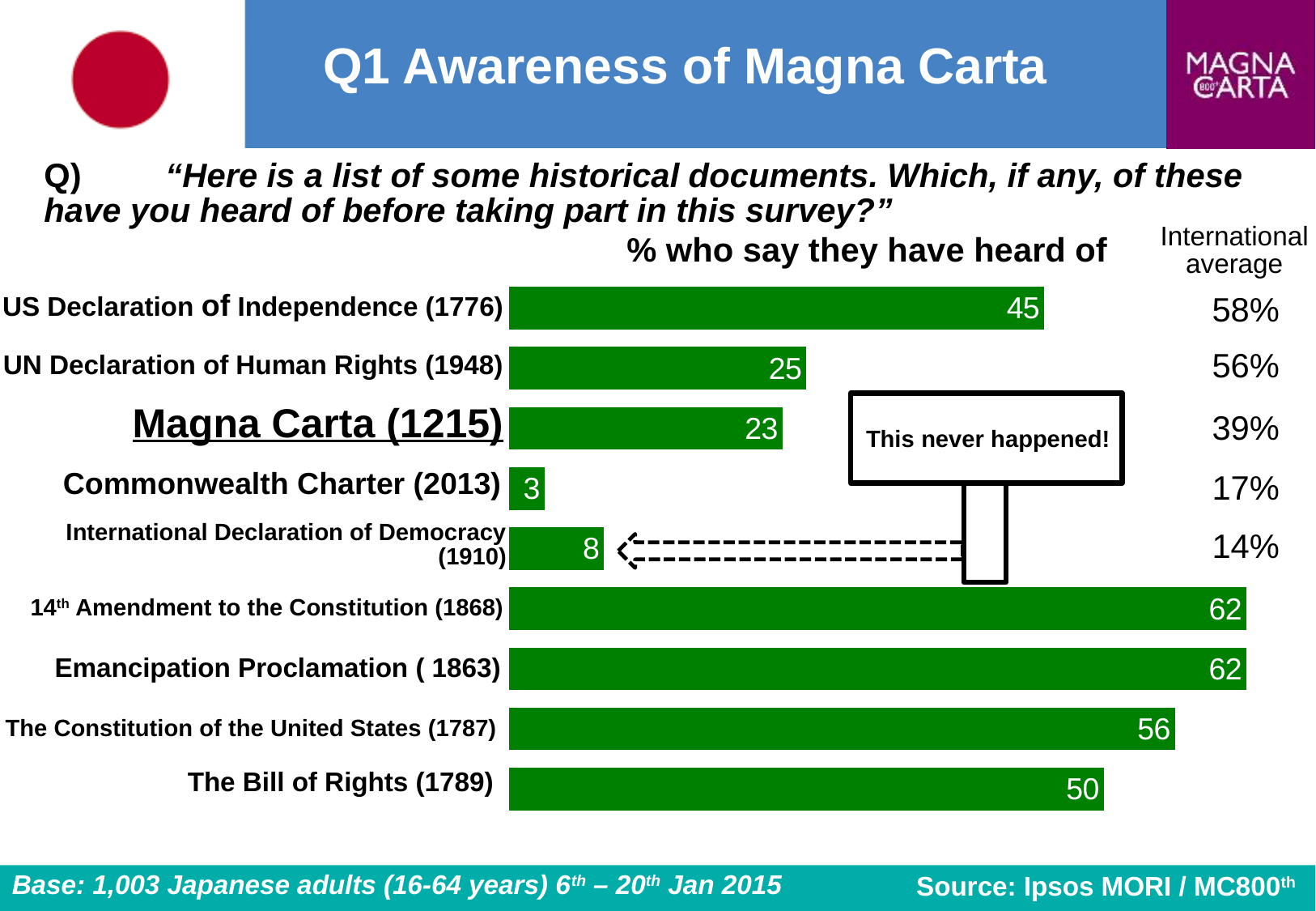
What is the difference between the values for the US Declaration of Independence (1776) and the UN Declaration of Human Rights (1948)? 20 What percentage of respondents say they have heard of the US Declaration of Independence (1776)? 45 What is the highest value shown on the chart? 62 What is the value shown for Magna Carta (1215)? 23 What value is shown for The Bill of Rights (1789)? 50 What is the international average shown for Magna Carta (1215)? 39% What kind of chart is shown on the slide? Bar chart Which has a higher value, the UN Declaration of Human Rights (1948) or Magna Carta (1215)? UN Declaration of Human Rights (1948) Which document has the lowest percentage of respondents who have heard of it? Commonwealth Charter (2013) What is the difference between the values for The Constitution of the United States (1787) and The Bill of Rights (1789)? 6 How many documents are listed on the chart? 9 What does the callout box on the chart say about the International Declaration of Democracy (1910)? This never happened!